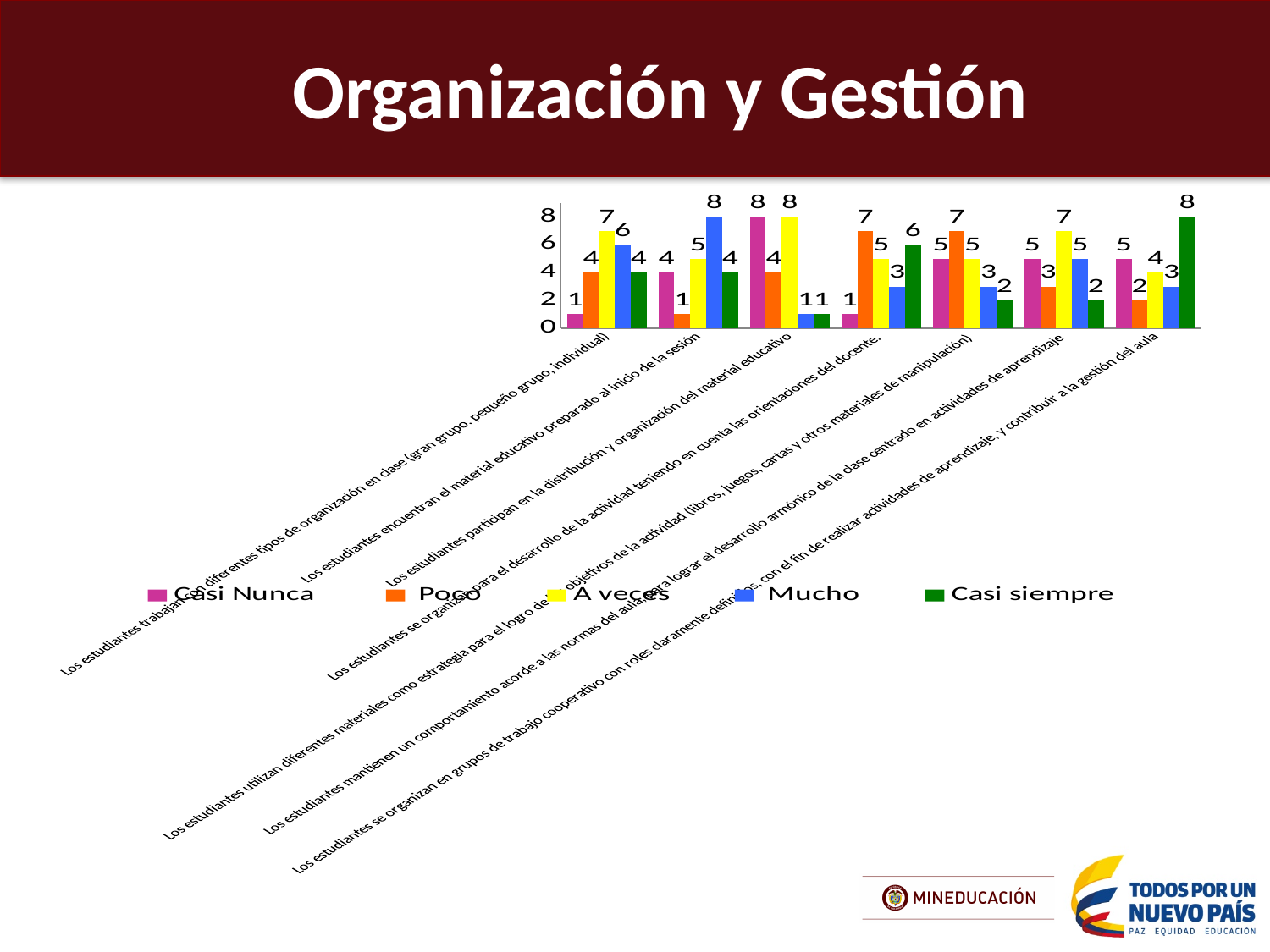
For 'Los estudiantes utilizan diferentes materiales como estrategia para el logro de los objetivos de la actividad', which is larger: 'Poco' or 'Casi siempre'? Poco What is the value of 'Mucho' for 'Los estudiantes encuentran el material educativo preparado al inicio de la sesión'? 8 Which colour represents the 'Mucho' series in the legend? blue What kind of chart is shown on the slide? bar chart How many series does the legend list? 5 Which series has the lowest value for 'Los estudiantes mantienen un comportamiento acorde a las normas del aula'? Casi siempre What is the value of 'Poco' for 'Los estudiantes se organizan para el desarrollo de la actividad teniendo en cuenta las orientaciones del docente'? 7 What is the value of 'Casi siempre' for 'Los estudiantes se organizan en grupos de trabajo cooperativo con roles claramente definidos'? 8 What is the difference between 'Casi Nunca' and 'Mucho' for 'Los estudiantes participan en la distribución y organización del material educativo'? 7 What is the value of 'A veces' for 'Los estudiantes mantienen un comportamiento acorde a las normas del aula'? 7 How many categories (statements) are plotted along the x axis? 7 Which series has the highest value for 'Los estudiantes trabajan con diferentes tipos de organización en clase'? A veces